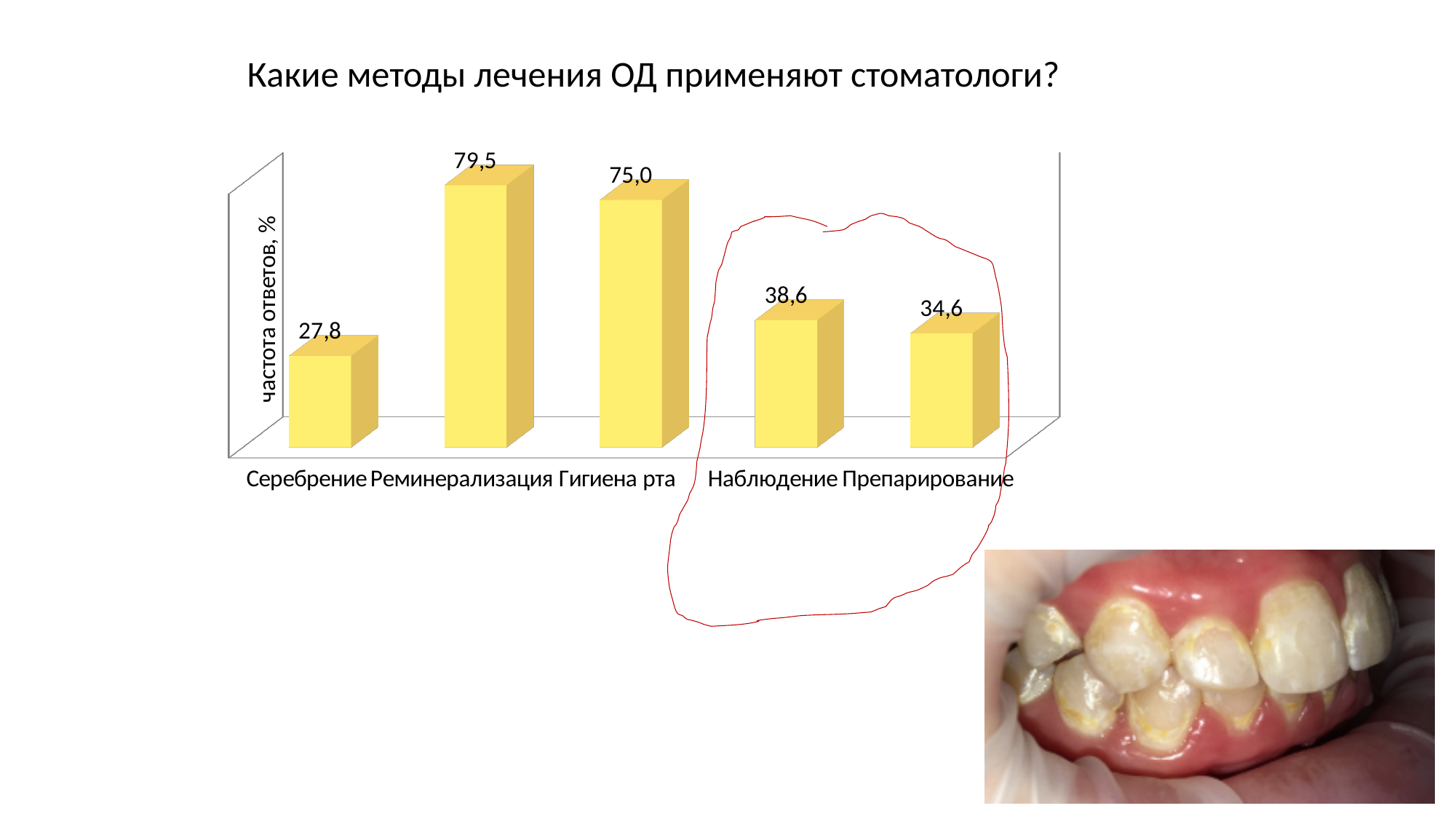
What is the value for Препарирование? 34,6 What kind of chart is shown on the slide? Bar chart What is the difference between the values for Реминерализация and Гигиена рта? 4,5 What is the value for Наблюдение? 38,6 What is the value for Реминерализация? 79,5 How many categories are shown on the x axis of the chart? 5 Which category has the lowest value? Серебрение What is the difference between the values for Наблюдение and Препарирование? 4,0 What is the value for Гигиена рта? 75,0 Which is larger, the value for Наблюдение or the value for Серебрение? Наблюдение What is the value for Серебрение? 27,8 Which category has the highest value? Реминерализация